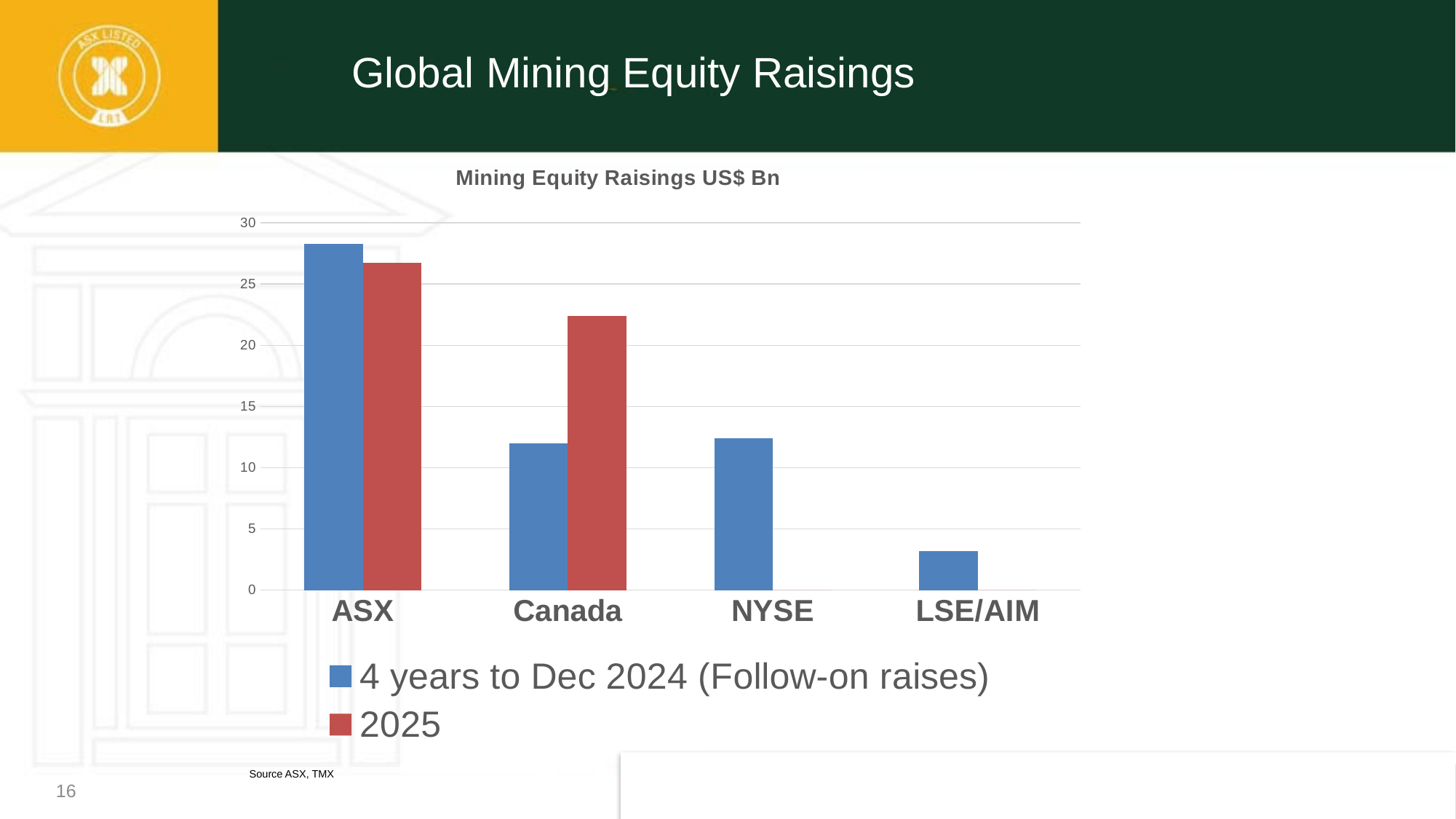
Is the '4 years to Dec 2024 (Follow-on raises)' value for ASX greater or less than 25? greater How many series does the legend list? 2 How many exchange categories are shown on the x axis? 4 For ASX, which is larger: the '4 years to Dec 2024 (Follow-on raises)' value or the 2025 value? 4 years to Dec 2024 (Follow-on raises) For Canada, which is larger: the '4 years to Dec 2024 (Follow-on raises)' value or the 2025 value? 2025 Which exchanges have no 2025 bar shown? NYSE and LSE/AIM Is the '4 years to Dec 2024 (Follow-on raises)' value for LSE/AIM greater or less than 5? less Which exchange has the lowest value for the '4 years to Dec 2024 (Follow-on raises)' series? LSE/AIM What is the title of the chart? Mining Equity Raisings US$ Bn What kind of chart is shown on the slide? bar chart Is the 2025 value for Canada greater or less than 20? greater Which exchange has the highest value for the '4 years to Dec 2024 (Follow-on raises)' series? ASX